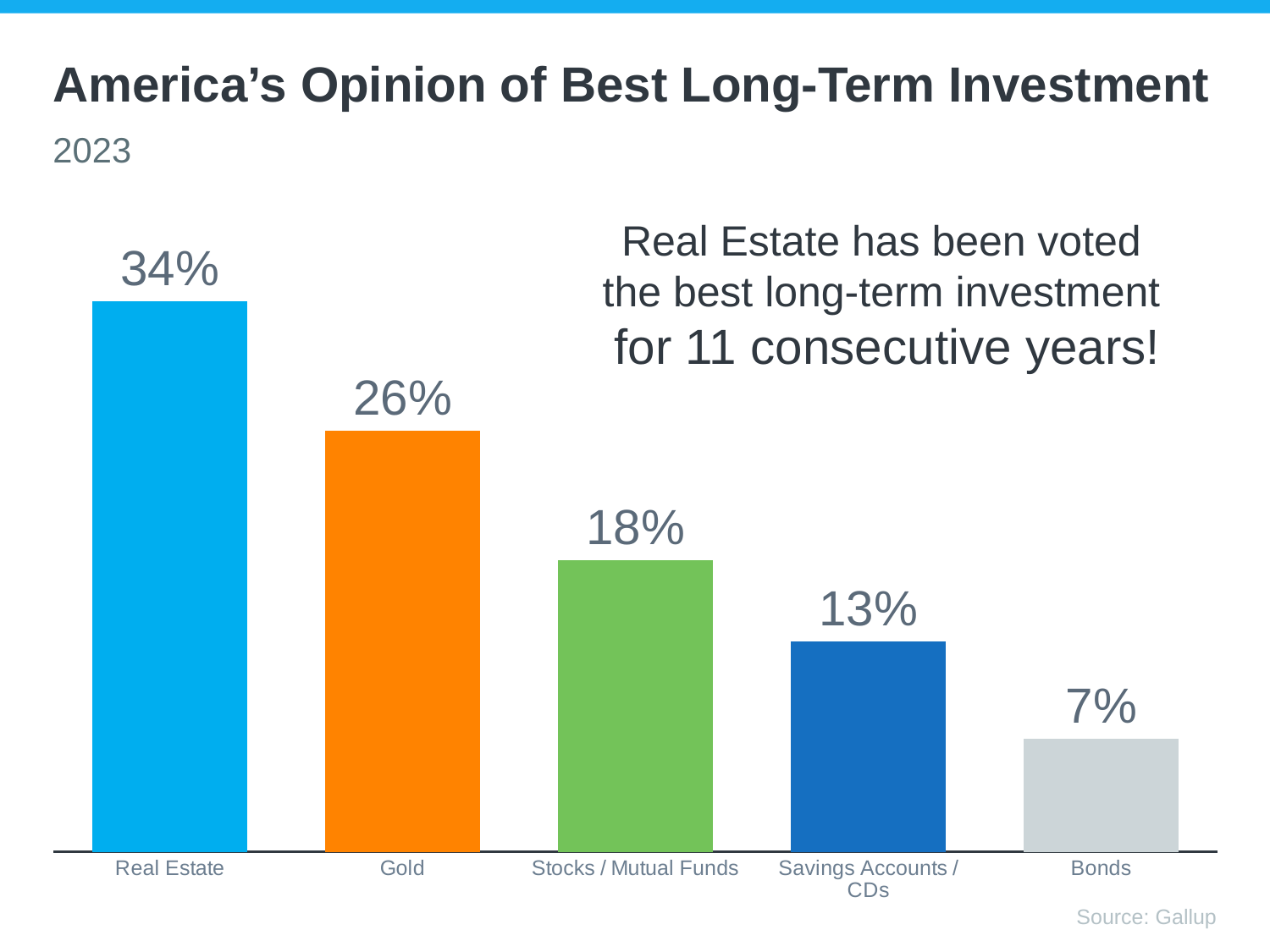
Which is larger, the value for Gold or the value for Savings Accounts / CDs? Gold What is the value shown for Bonds? 7% What is the value shown for Savings Accounts / CDs? 13% What is the difference between the values for Stocks / Mutual Funds and Bonds? 11% What is the value shown for Stocks / Mutual Funds? 18% What kind of chart is shown on the slide? Bar chart What is the value shown for Gold? 26% What is the difference between the values for Real Estate and Gold? 8% Which category has the highest value? Real Estate How many categories are shown in the chart? 5 What percentage of Americans chose Real Estate as the best long-term investment? 34% Which category has the lowest value? Bonds